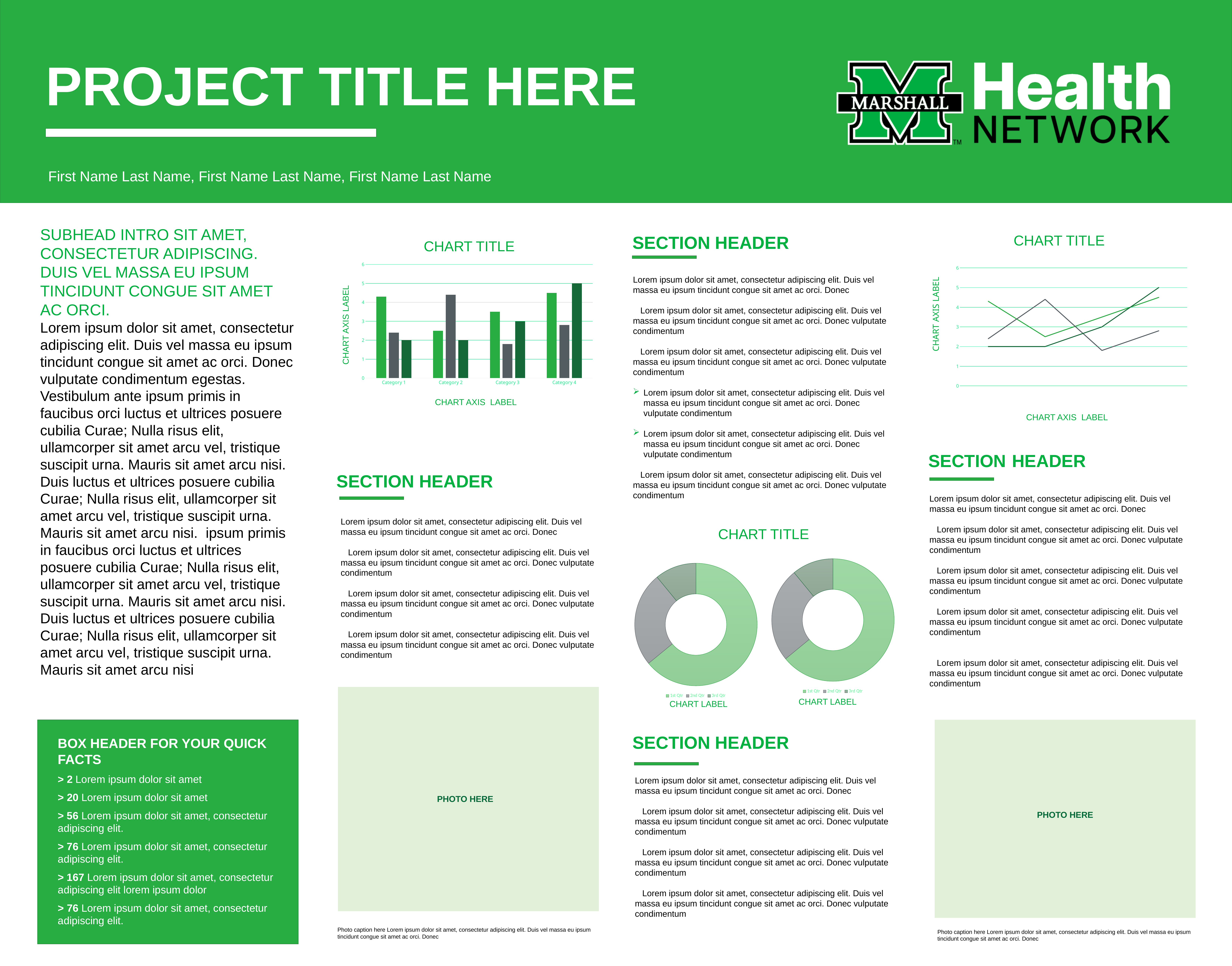
How many entries does the legend list for each of the two doughnut charts in the middle of the slide? 3 In the bar chart at the top of the second column, which category contains the tallest bar overall? Category 4 In the bar chart at the top of the second column, is the tallest bar for Category 1 greater or less than 3? greater In the bar chart at the top of the second column, how many bars are plotted for each category? 3 In the bar chart at the top of the second column, is the tallest bar for Category 3 greater or less than 4? less What kind of chart is the chart at the top of the right-hand column? line chart What kind of chart is the chart at the top of the second column (left of the SECTION HEADER text)? bar chart In the bar chart at the top of the second column, is the tallest bar for Category 4 greater or less than 4? greater In the bar chart at the top of the second column, how many categories are shown on the x axis? 4 What is the x-axis label of the bar chart at the top of the second column? CHART AXIS LABEL How many lines are plotted in the line chart at the top of the right-hand column? 3